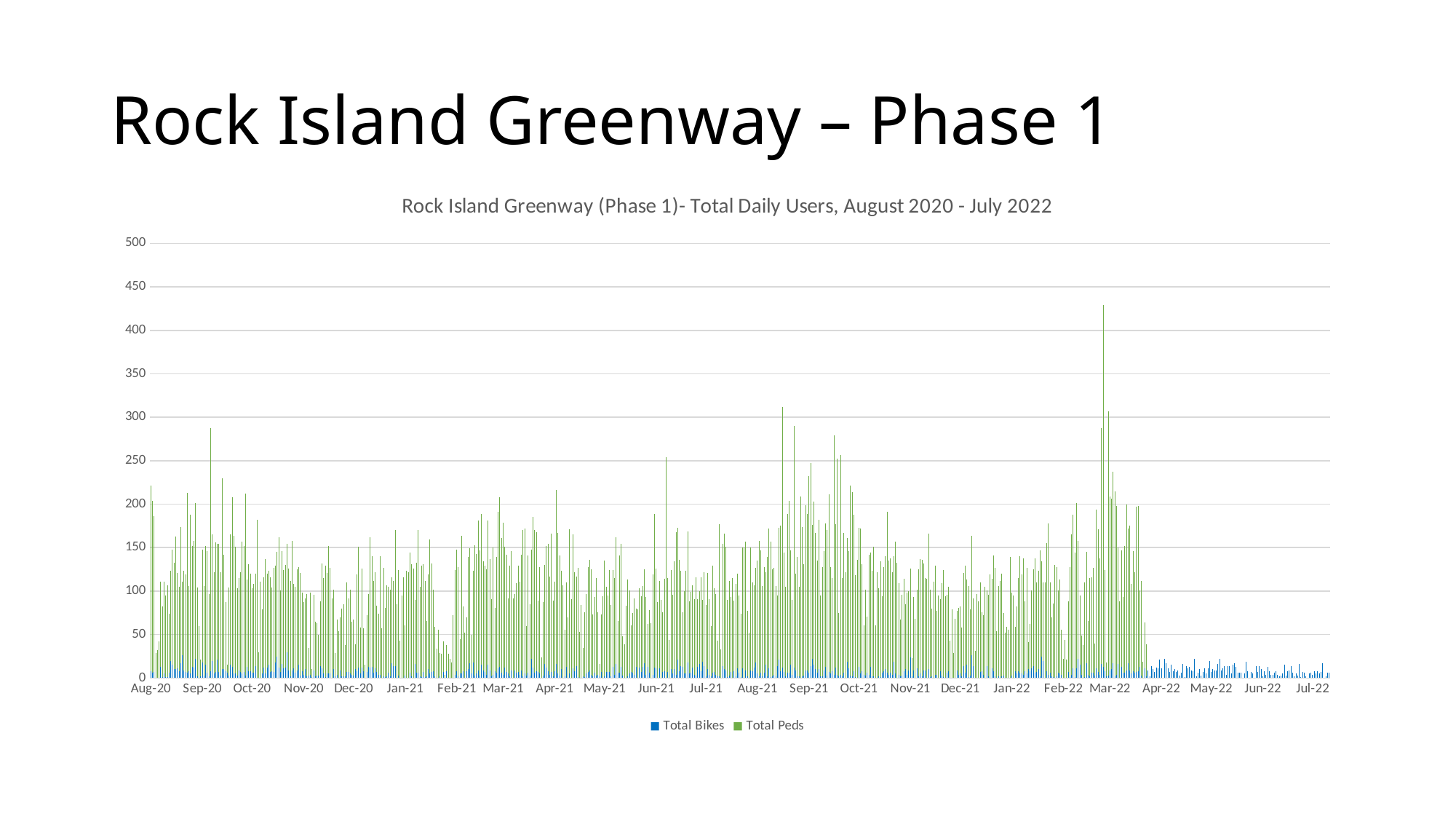
Which colour represents the Total Peds series? Green Do the daily user values rise or fall after Mar-22? Fall Which series generally has the larger daily values, Total Bikes or Total Peds? Total Peds Are the Total Bikes values in Sep-21 greater or less than 50? less How many month labels are shown on the x axis? 24 What is the title of the chart? Rock Island Greenway (Phase 1)- Total Daily Users, August 2020 - July 2022 How many series does the legend list? 2 What is the highest value shown on the y axis? 500 Is the tallest Total Peds bar, near Mar-22, greater or less than 400? greater What kind of chart is shown on the slide? Bar chart